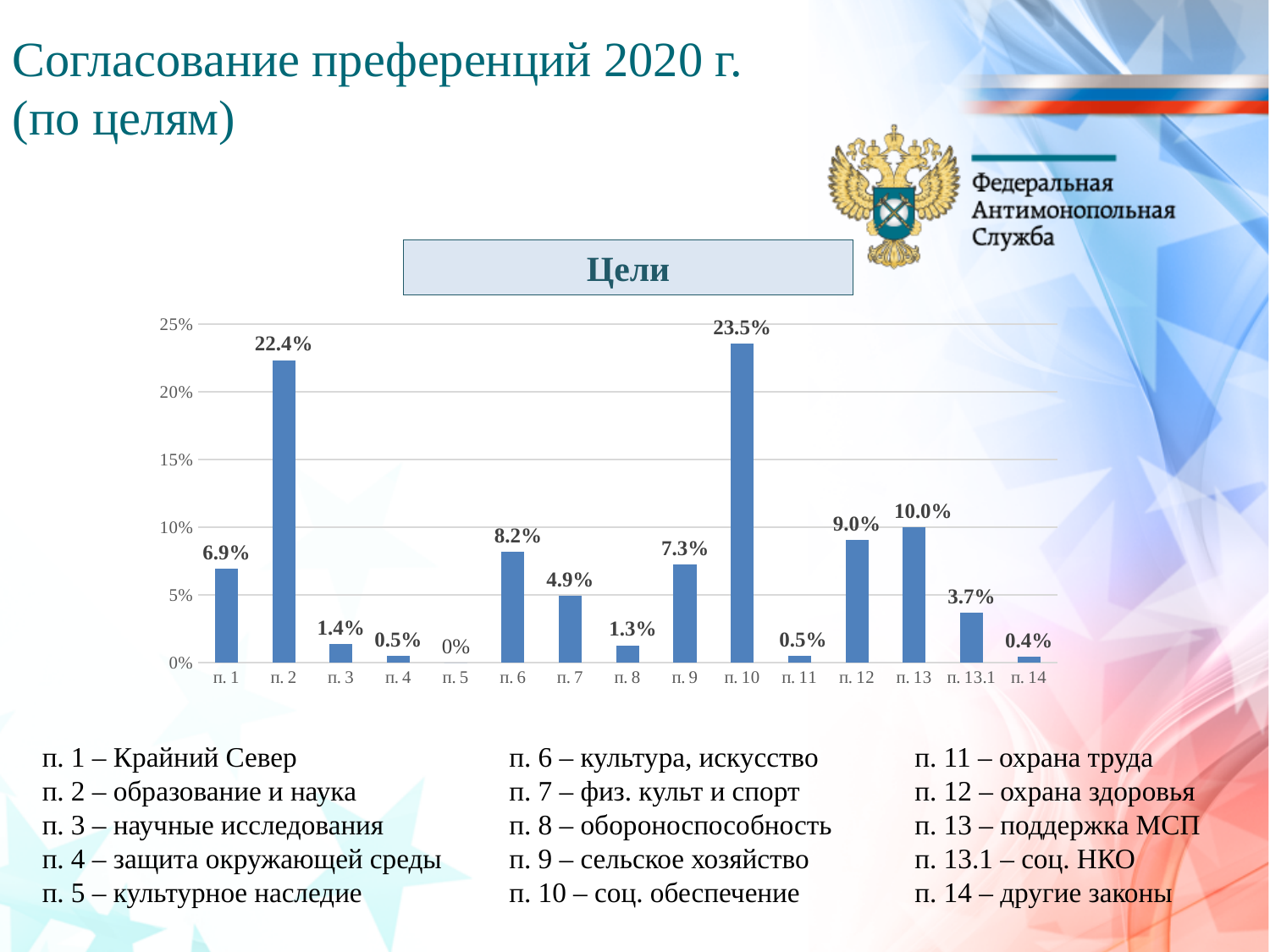
What is the difference between the values for п. 10 and п. 2? 1.1% Which is larger, the value for п. 13 or the value for п. 12? п. 13 What is the title of the chart? Цели What is the value for п. 5 in the chart? 0% What type of chart is shown on the slide? bar chart Which category has the lowest value in the chart? п. 5 Which category has the highest value in the chart? п. 10 What is the value for п. 13.1 in the chart? 3.7% What is the value for п. 2 in the chart? 22.4% How many categories are shown on the x axis of the chart? 15 What is the value for п. 10 in the chart? 23.5% Is the value for п. 6 greater or less than 5%? greater